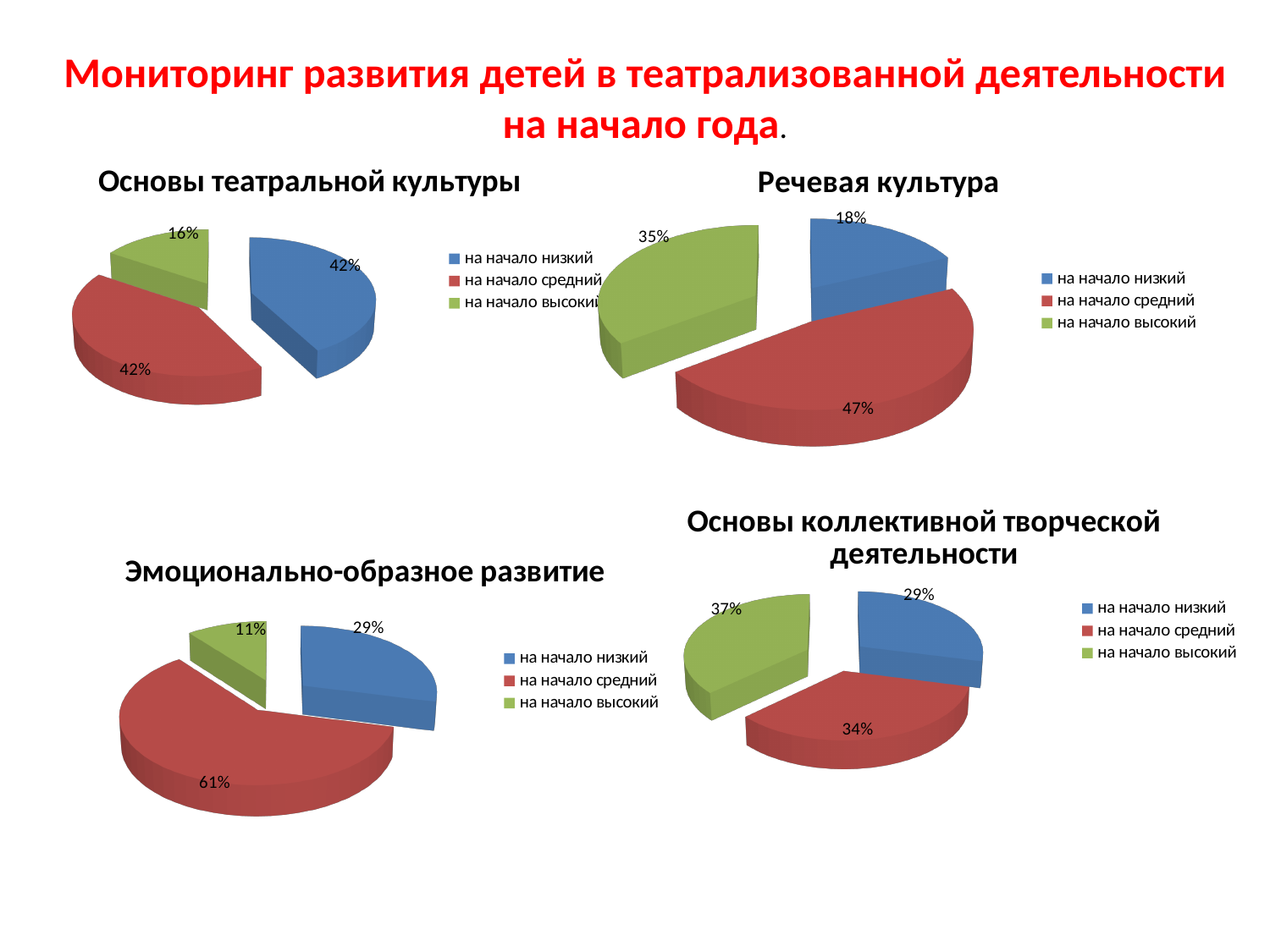
In the "Основы коллективной творческой деятельности" chart, what is the value for "на начало высокий"? 37% In the "Эмоционально-образное развитие" chart, which category has the smallest share? на начало высокий In the "Основы коллективной творческой деятельности" chart, which is larger: "на начало средний" or "на начало высокий"? на начало высокий In the "Речевая культура" chart, what is the difference between "на начало средний" and "на начало низкий"? 29% How many pie charts are shown on the slide? 4 In the "Речевая культура" chart, which category has the largest share? на начало средний What kind of chart is used for "Речевая культура"? pie chart In the "Эмоционально-образное развитие" chart, what is the value for "на начало низкий"? 29% In the "Основы театральной культуры" chart, what is the value for "на начало высокий"? 16% How many entries does the legend of the "Эмоционально-образное развитие" chart list? 3 In the "Речевая культура" chart, what is the value for "на начало средний"? 47% In the "Основы театральной культуры" chart, which category has the smallest share? на начало высокий